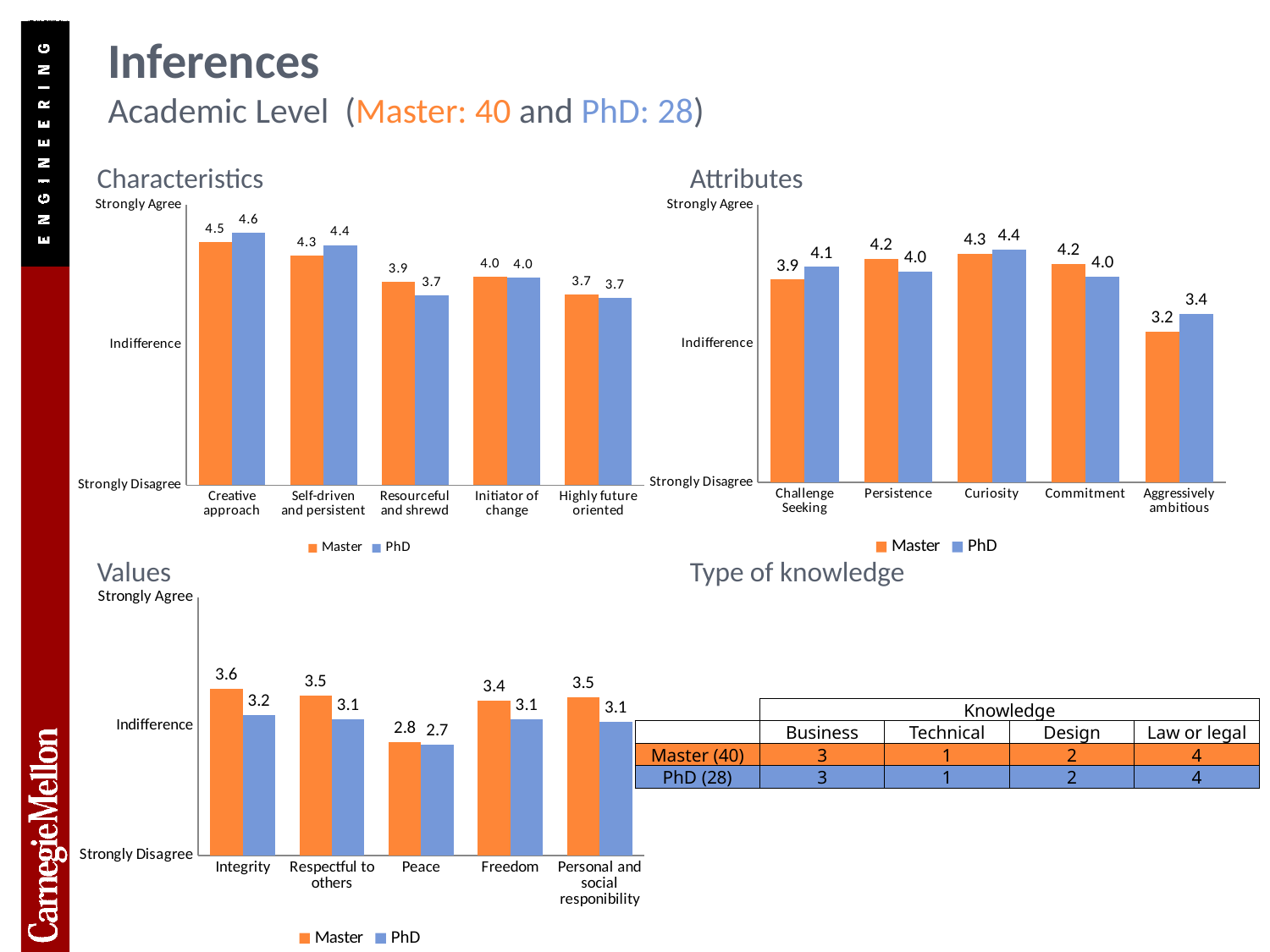
How many categories are shown in the Values chart? 5 In the Attributes chart, which is larger for Persistence, the Master value or the PhD value? Master How many series does the legend of the Characteristics chart list? 2 In the Characteristics chart, which category has the highest PhD value? Creative approach In the Characteristics chart, what is the Master value for Creative approach? 4.5 In the Attributes chart, which category has the lowest Master value? Aggressively ambitious In the Values chart, what is the difference between the Master and PhD values for Integrity? 0.4 In the Values chart, which category has the lowest PhD value? Peace In the Characteristics chart, what is the PhD value for Resourceful and shrewd? 3.7 In the Attributes chart, what is the PhD value for Aggressively ambitious? 3.4 In the Values chart, what is the Master value for Integrity? 3.6 In the Attributes chart, what is the difference between the Master and PhD values for Challenge Seeking? 0.2